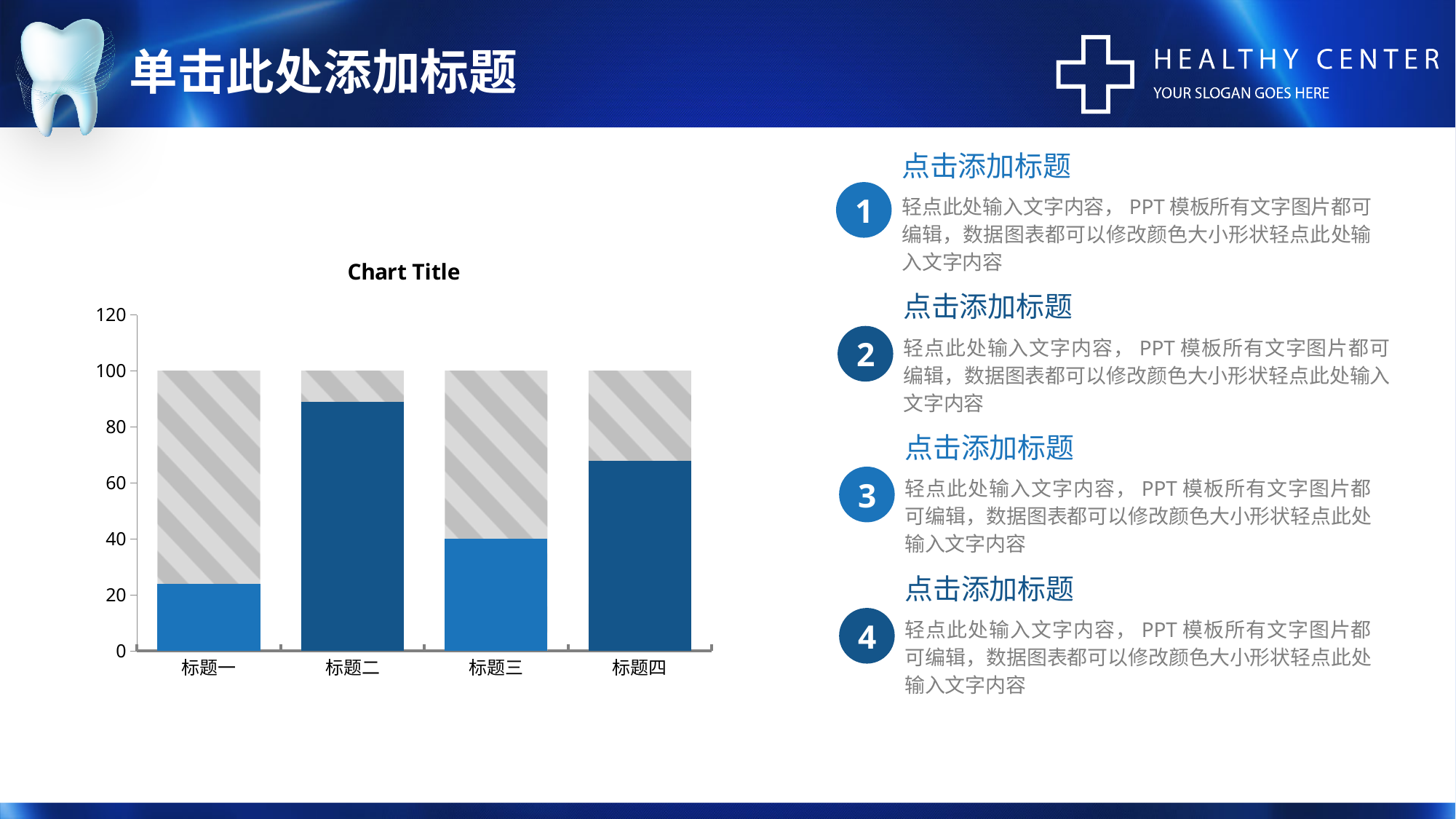
Is the value of the blue bar for 标题三 greater or less than 60? less Is the blue bar for 标题一 or 标题二 taller? 标题二 How many categories are shown on the x axis of the chart? 4 What value on the y axis do the gray striped bars reach for every category? 100 What kind of chart is shown on the slide? bar chart Which category has the tallest blue bar? 标题二 Is the value of the blue bar for 标题四 greater or less than 60? greater Which category has the shortest blue bar? 标题一 What is the title of the chart? Chart Title Is the value of the blue bar for 标题一 greater or less than 40? less Is the blue bar for 标题三 or 标题四 taller? 标题四